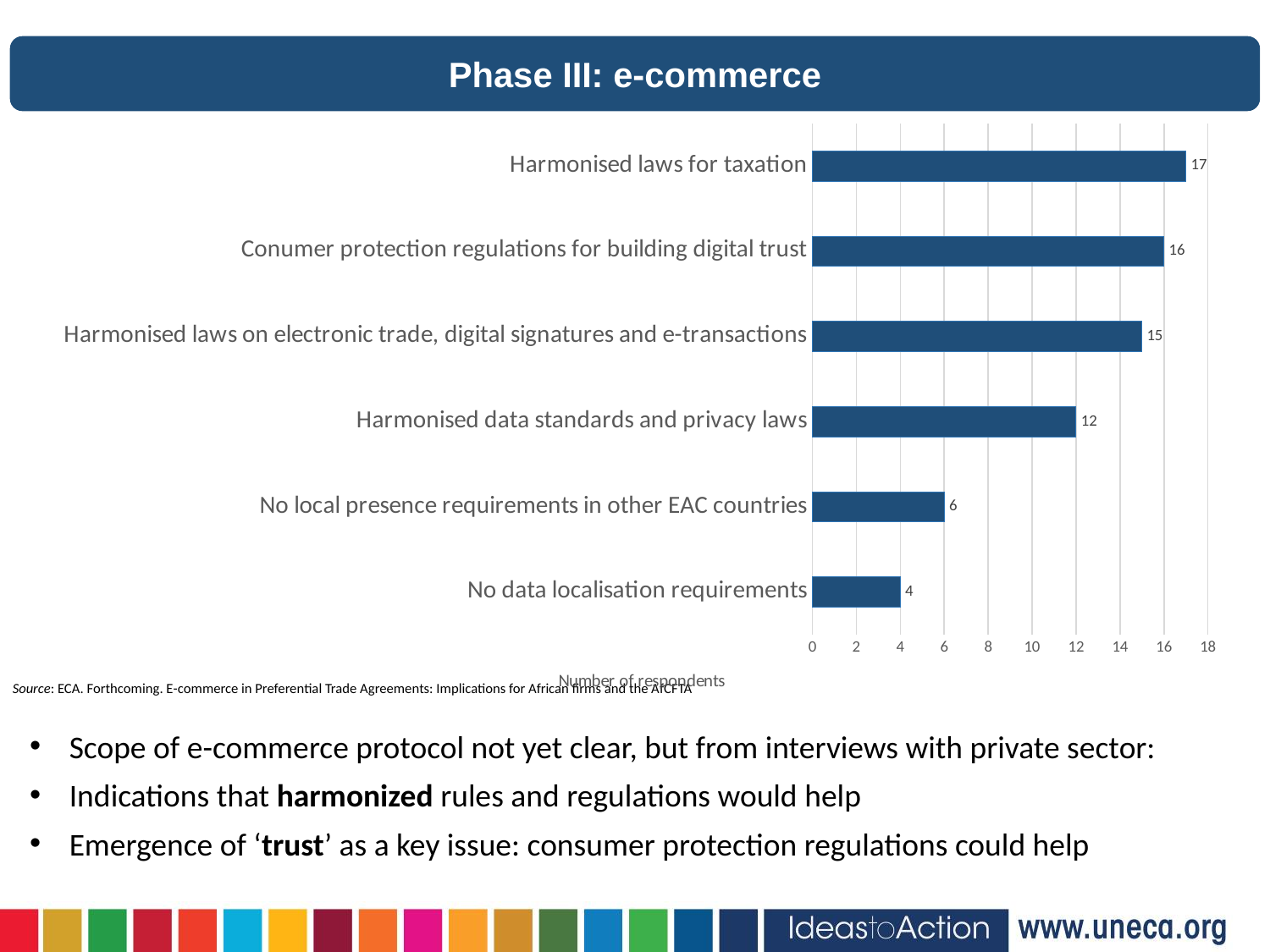
What is the value for 'Conumer protection regulations for building digital trust'? 16 What is the difference in respondents between 'Harmonised laws for taxation' and 'No local presence requirements in other EAC countries'? 11 What is the number of respondents for 'Harmonised laws for taxation'? 17 Which category has the lowest number of respondents? No data localisation requirements Which has more respondents: 'Harmonised data standards and privacy laws' or 'No local presence requirements in other EAC countries'? Harmonised data standards and privacy laws What kind of chart is shown on the slide? bar chart What is the label of the horizontal axis of the chart? Number of respondents How many categories are shown in the chart? 6 What is the number of respondents for 'Harmonised data standards and privacy laws'? 12 What is the number of respondents for 'No data localisation requirements'? 4 Is the value for 'Harmonised laws on electronic trade, digital signatures and e-transactions' greater or less than 10? greater Which category has the highest number of respondents? Harmonised laws for taxation